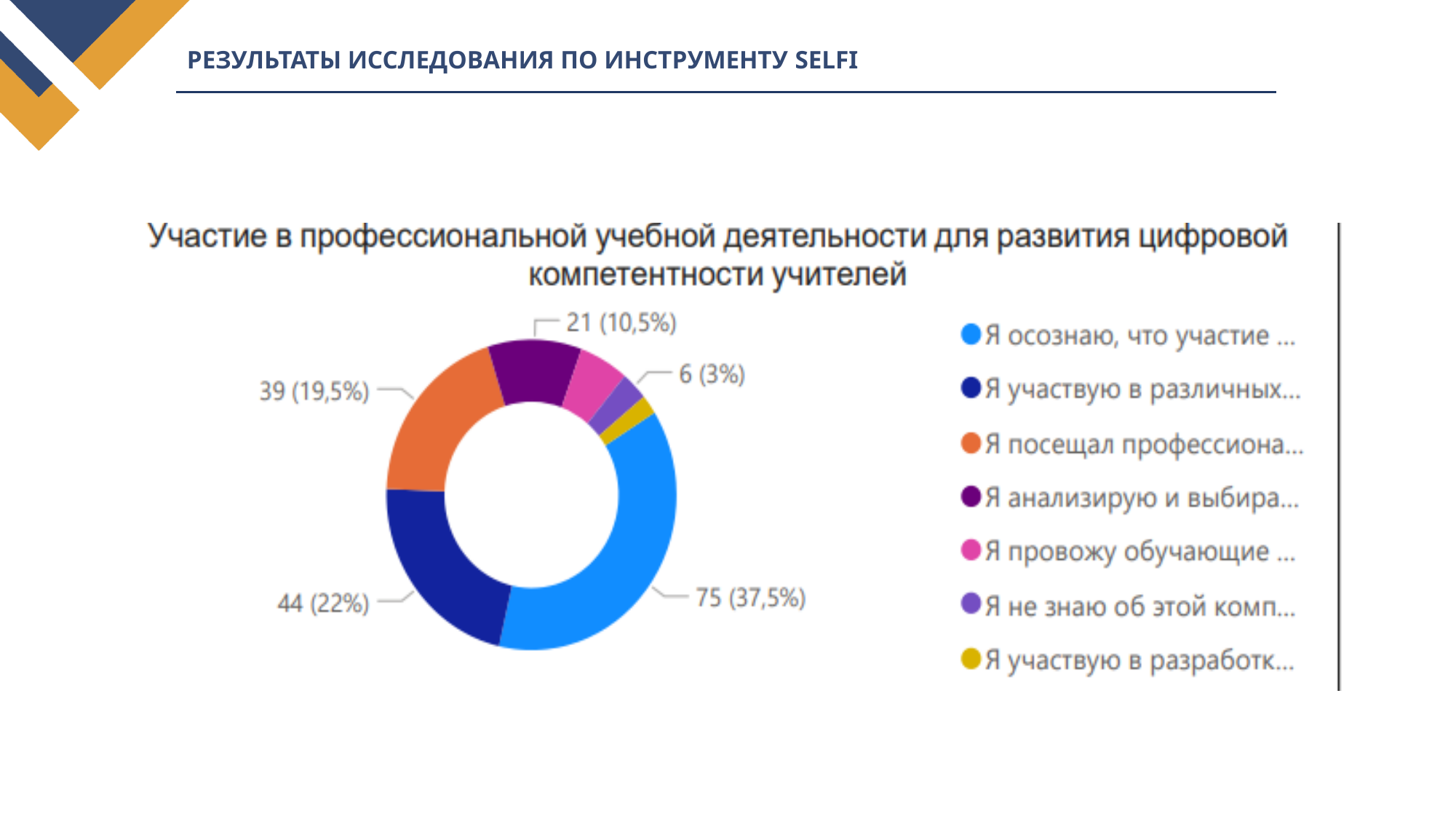
What is the difference in count between the light blue slice (75) and the dark blue slice (44)? 31 How many categories does the legend of the chart list? 7 What kind of chart is shown on the slide? Pie chart (donut) Which legend category has the largest slice in the chart? Я осознаю, что участие ... What value is shown for the dark purple slice ("Я анализирую и выбира...")? 21 (10,5%) Which slice is larger: the dark blue one ("Я участвую в различных...") or the orange one ("Я посещал профессиона...")? Dark blue (Я участвую в различных...) What share of the pie does the orange slice ("Я посещал профессиона...") represent? 19,5% What value is shown for the dark blue slice ("Я участвую в различных...")? 44 (22%) What value is shown for the largest slice (light blue, "Я осознаю, что участие ...")? 75 (37,5%) What is the title of the chart? Участие в профессиональной учебной деятельности для развития цифровой компетентности учителей What colour is the slice for "Я анализирую и выбира..." in the chart? Dark purple What value is shown for the orange slice ("Я посещал профессиона...")? 39 (19,5%)